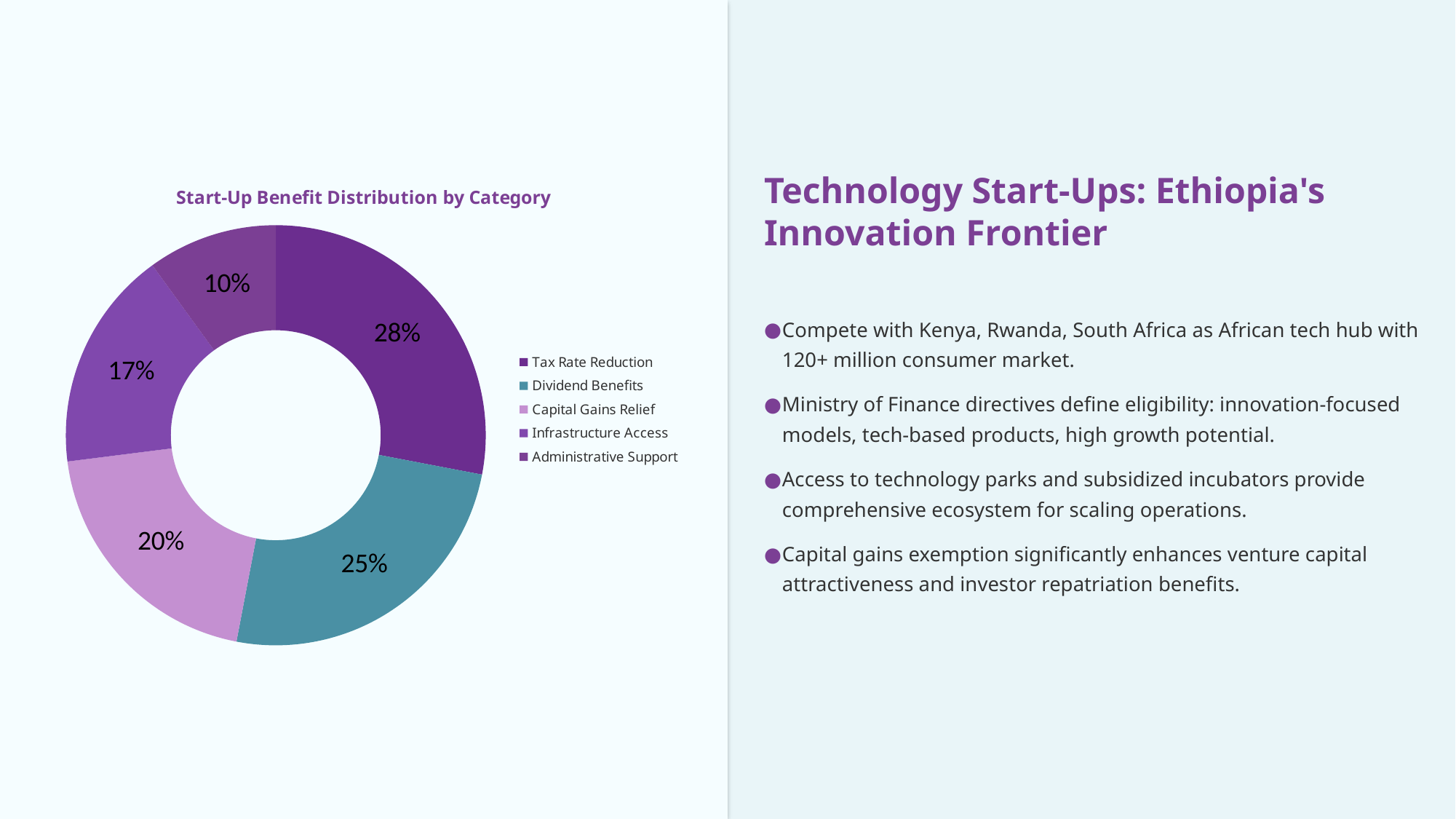
What kind of chart is shown on the slide? Doughnut chart What share of the pie does Capital Gains Relief hold? 20% How many categories are shown in the pie chart? 5 What share of the pie does Infrastructure Access hold? 17% What share of the pie does Tax Rate Reduction hold? 28% Which category has the largest share of the pie? Tax Rate Reduction Which is larger, the share for Dividend Benefits or the share for Capital Gains Relief? Dividend Benefits Which category has the smallest share of the pie? Administrative Support What share of the pie does Dividend Benefits hold? 25% What is the difference in percentage points between Tax Rate Reduction and Administrative Support? 18 What is the title of the chart? Start-Up Benefit Distribution by Category What share of the pie does Administrative Support hold? 10%